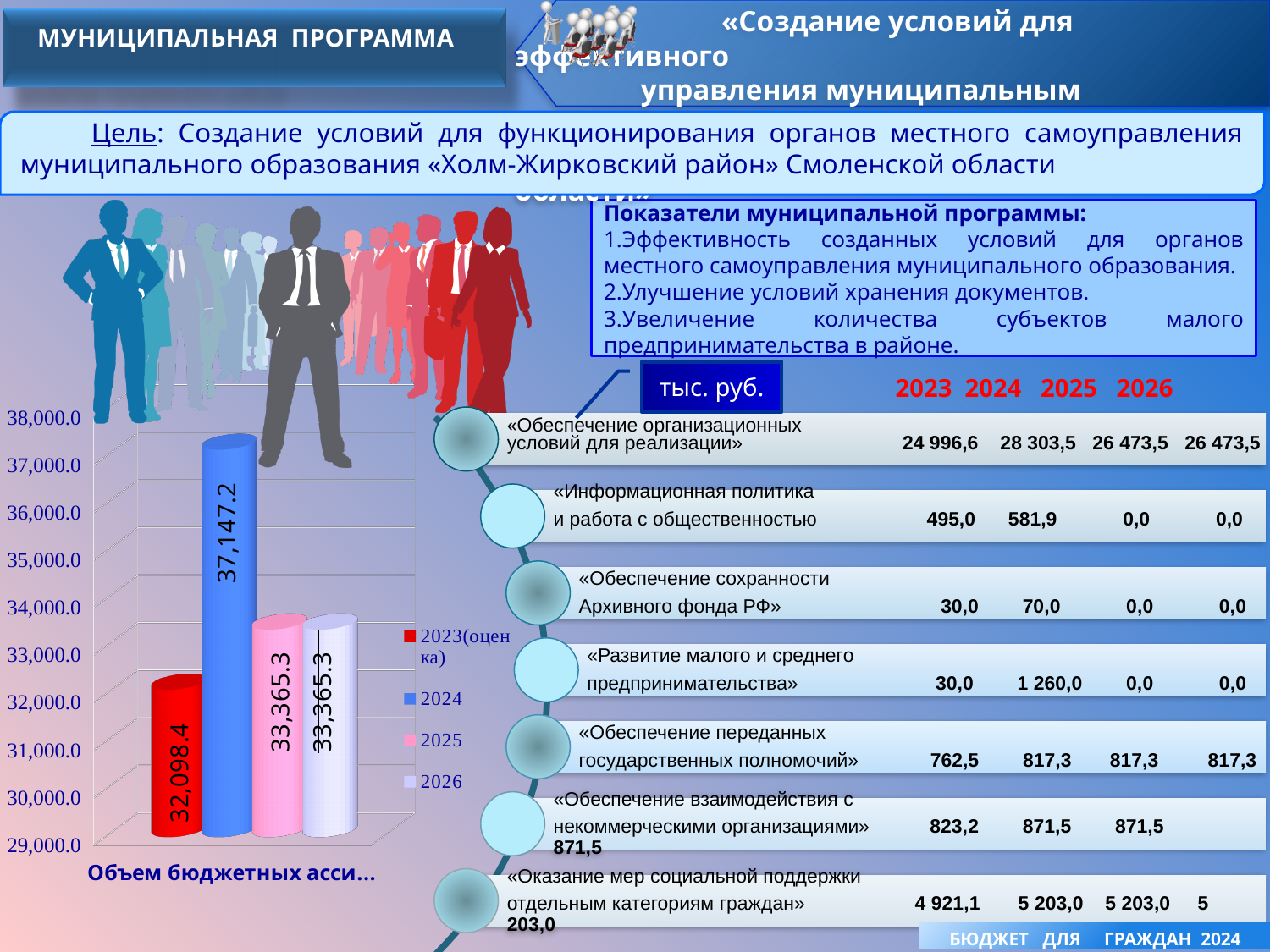
Which year has the lowest value in the bar chart? 2023(оценка) What is the value for 2023(оценка) in the bar chart? 32,098.4 Which is larger in the bar chart, the value for 2024 or the value for 2025? 2024 What is the value for 2024 in the bar chart? 37,147.2 How many bars are plotted in the bar chart? 4 What type of chart is shown on the slide? bar chart What is the value for 2025 in the bar chart? 33,365.3 What is the value for 2026 in the bar chart? 33,365.3 What is the difference between the values for 2024 and 2023(оценка) in the bar chart? 5,048.8 What colour is the bar for 2023(оценка) in the bar chart? red Which year has the highest value in the bar chart? 2024 How many series does the legend of the bar chart list? 4